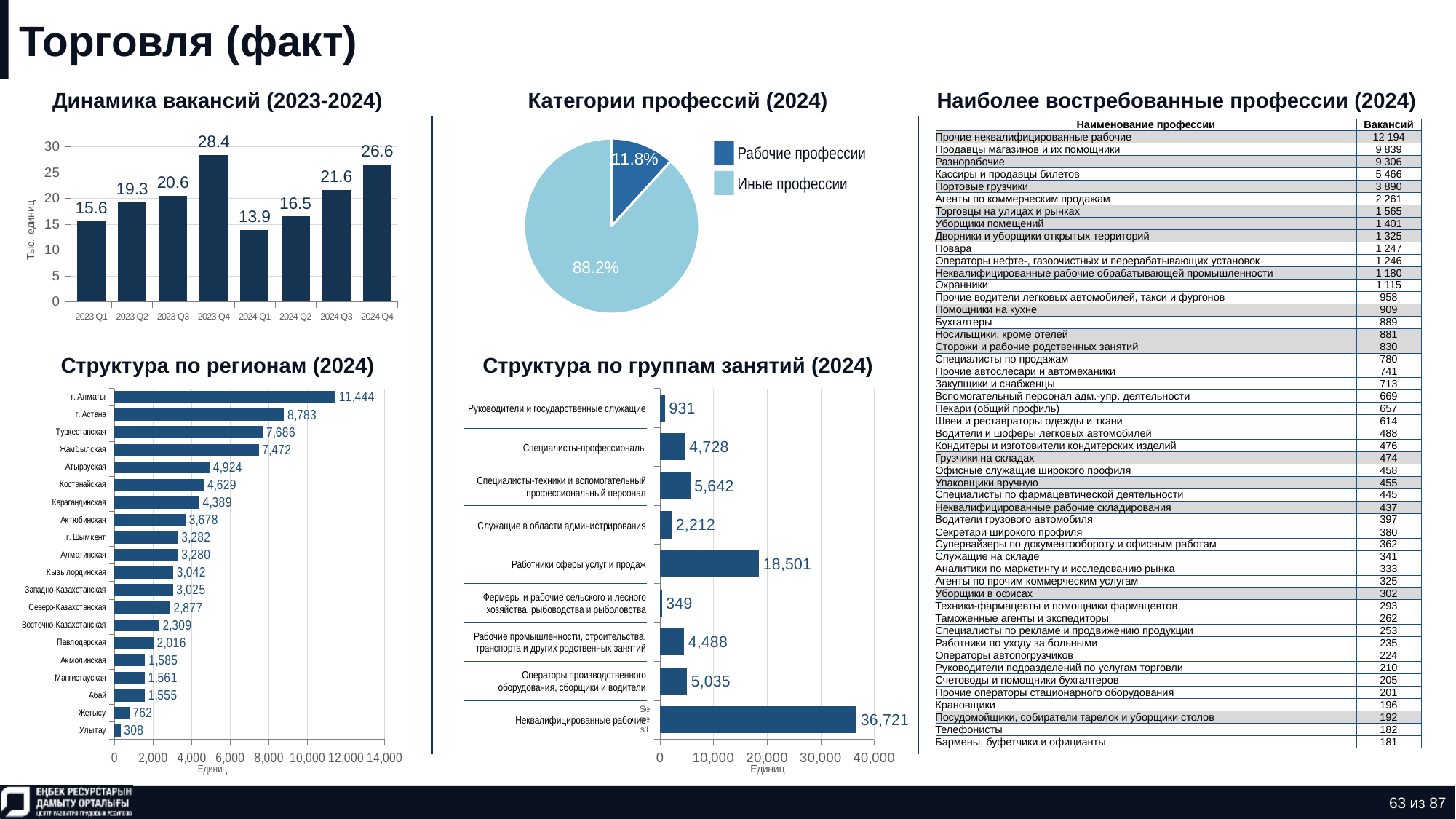
What kind of chart is 'Категории профессий (2024)'? Pie chart In the chart 'Динамика вакансий (2023-2024)', how many quarters are plotted? 8 In the chart 'Структура по регионам (2024)', what is the value for г. Астана? 8,783 In the chart 'Динамика вакансий (2023-2024)', what is the difference between 2024 Q4 and 2024 Q3? 5.0 In the chart 'Структура по группам занятий (2024)', what is the value for 'Работники сферы услуг и продаж'? 18,501 In the chart 'Структура по регионам (2024)', which region has the highest value? г. Алматы In the chart 'Структура по регионам (2024)', which region has the lowest value? Улытау In the chart 'Динамика вакансий (2023-2024)', which quarter has the lowest value? 2024 Q1 What kind of chart is 'Структура по регионам (2024)'? Bar chart In the chart 'Структура по группам занятий (2024)', which is larger: 'Специалисты-профессионалы' or 'Рабочие промышленности, строительства, транспорта и других родственных занятий'? Специалисты-профессионалы In the chart 'Категории профессий (2024)', what share of the pie is 'Рабочие профессии'? 11.8% In the chart 'Динамика вакансий (2023-2024)', what is the value for 2023 Q4? 28.4